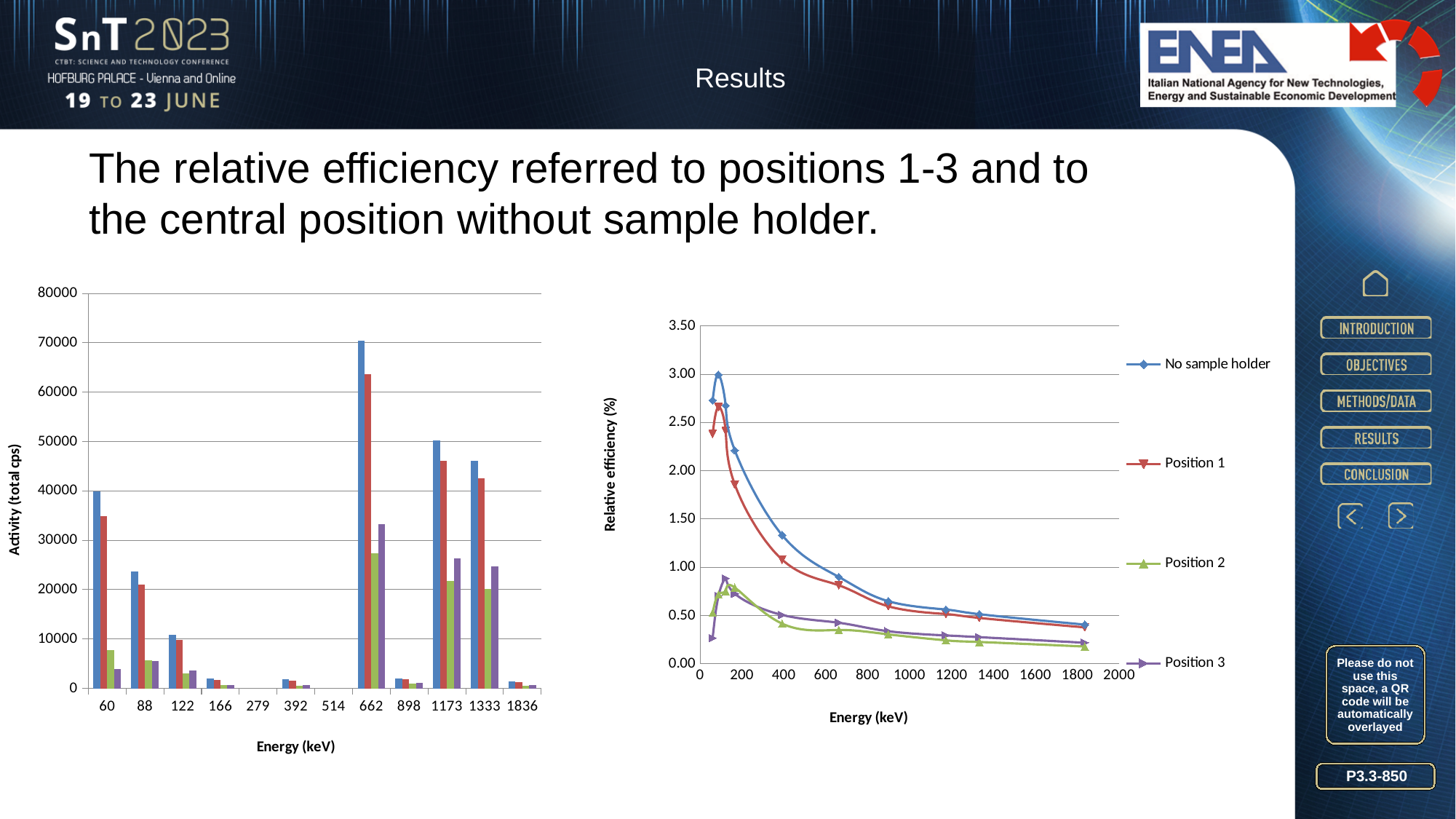
In the left bar chart, is the blue bar at 662 keV greater or less than 60000? greater How many energy categories are shown on the x axis of the left bar chart? 12 In the left bar chart, at which energy (keV) is the tallest bar found? 662 In the right line chart, is the peak value of the No sample holder series greater or less than 2.50? greater In the right line chart, does the No sample holder series rise or fall as energy increases from 400 keV to 1800 keV? fall In the right line chart, which series has the highest relative efficiency at around 400 keV? No sample holder How many series does the legend of the right line chart list? 4 What is the y-axis label of the left bar chart? Activity (total cps) In the left bar chart, is the blue bar at 60 keV greater or less than 30000? greater What kind of chart is the left chart showing Activity (total cps) against Energy (keV)? bar chart What kind of chart is the right chart showing Relative efficiency (%) against Energy (keV)? line chart